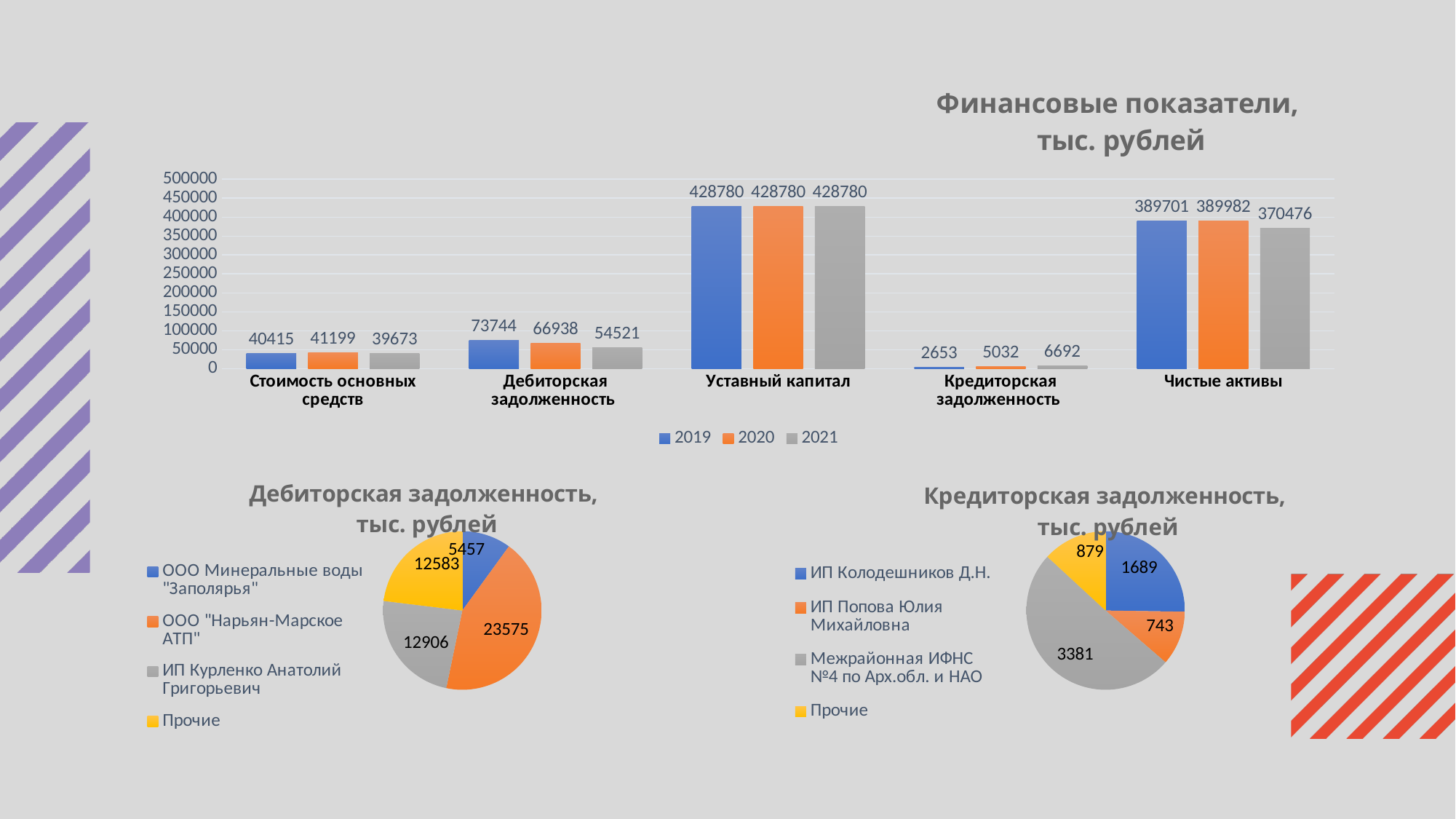
What kind of chart is 'Дебиторская задолженность, тыс. рублей'? pie chart In the pie chart 'Дебиторская задолженность, тыс. рублей', what is the value for ИП Курленко Анатолий Григорьевич? 12906 In the chart 'Финансовые показатели, тыс. рублей', which is larger: Стоимость основных средств in 2020 or in 2021? 2020 In the chart 'Финансовые показатели, тыс. рублей', do the values for Кредиторская задолженность rise or fall from 2019 to 2021? rise How many series does the legend of the chart 'Финансовые показатели, тыс. рублей' list? 3 In the chart 'Финансовые показатели, тыс. рублей', which category has the lowest value in 2019? Кредиторская задолженность In the chart 'Финансовые показатели, тыс. рублей', what is the value for Дебиторская задолженность in 2021? 54521 How many categories are shown on the x axis of the chart 'Финансовые показатели, тыс. рублей'? 5 In the chart 'Финансовые показатели, тыс. рублей', what is the value for Уставный капитал in 2019? 428780 In the pie chart 'Кредиторская задолженность, тыс. рублей', what is the difference between the values for ИП Колодешников Д.Н. and ИП Попова Юлия Михайловна? 946 In the chart 'Финансовые показатели, тыс. рублей', what is the difference between the 2020 and 2021 values for Чистые активы? 19506 In the pie chart 'Кредиторская задолженность, тыс. рублей', which slice is the largest? Межрайонная ИФНС №4 по Арх.обл. и НАО